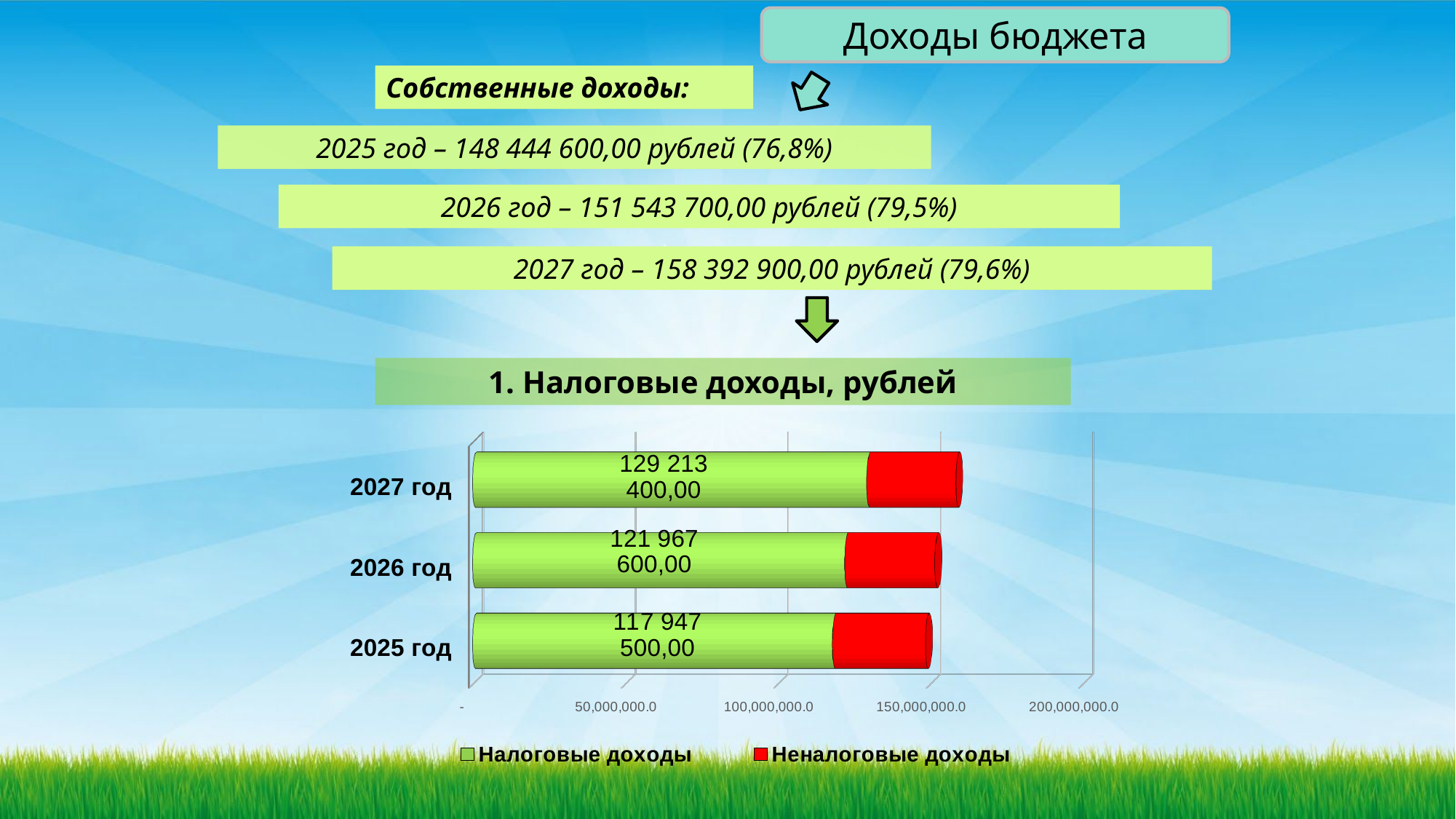
What is the value of Налоговые доходы for 2026 год? 121 967 600,00 How many years are shown in the chart? 3 How many series does the legend list? 2 What is the difference in Налоговые доходы between 2026 год and 2025 год? 4 020 100,00 Is the value of Налоговые доходы for 2027 год greater or less than 150,000,000.0? less What is the value of Налоговые доходы for 2027 год? 129 213 400,00 Which year has the highest Налоговые доходы? 2027 год What is the difference in Налоговые доходы between 2027 год and 2026 год? 7 245 800,00 What kind of chart is shown on the slide? stacked bar chart Do the Налоговые доходы values rise or fall from 2025 год to 2027 год? rise What is the value of Налоговые доходы for 2025 год? 117 947 500,00 Which year has the lowest Налоговые доходы? 2025 год